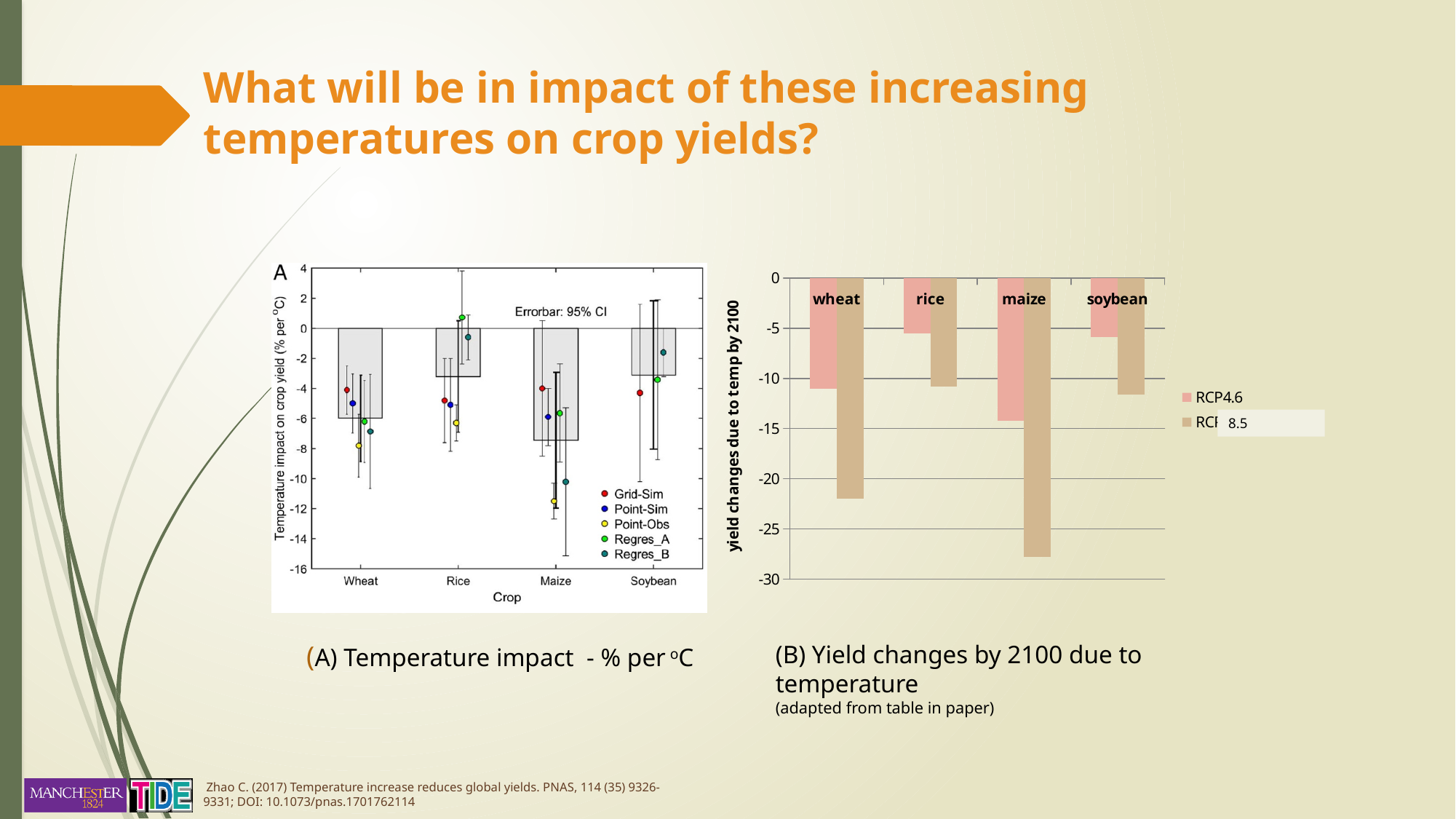
In chart (B) Yield changes by 2100 due to temperature, is the RCP8.5 value for maize greater or less than -25? less In chart (A) Temperature impact, how many series does the legend list? 5 In chart (A) Temperature impact, what confidence interval do the error bars represent according to the note on the chart? 95% CI In chart (B) Yield changes by 2100 due to temperature, is the RCP4.6 value for rice greater or less than -10? greater In chart (B) Yield changes by 2100 due to temperature, is the RCP4.6 value for maize greater or less than -10? less In chart (B) Yield changes by 2100 due to temperature, how many series does the legend list? 2 In chart (B) Yield changes by 2100 due to temperature, which has the larger yield decline under RCP8.5: wheat or rice? wheat In chart (B) Yield changes by 2100 due to temperature, which crop shows the largest yield decline under RCP8.5? maize In chart (B) Yield changes by 2100 due to temperature, how many crops are shown on the x axis? 4 In chart (B) Yield changes by 2100 due to temperature, what kind of chart is shown? bar chart In chart (B) Yield changes by 2100 due to temperature, which crop shows the largest yield decline under RCP4.6? maize